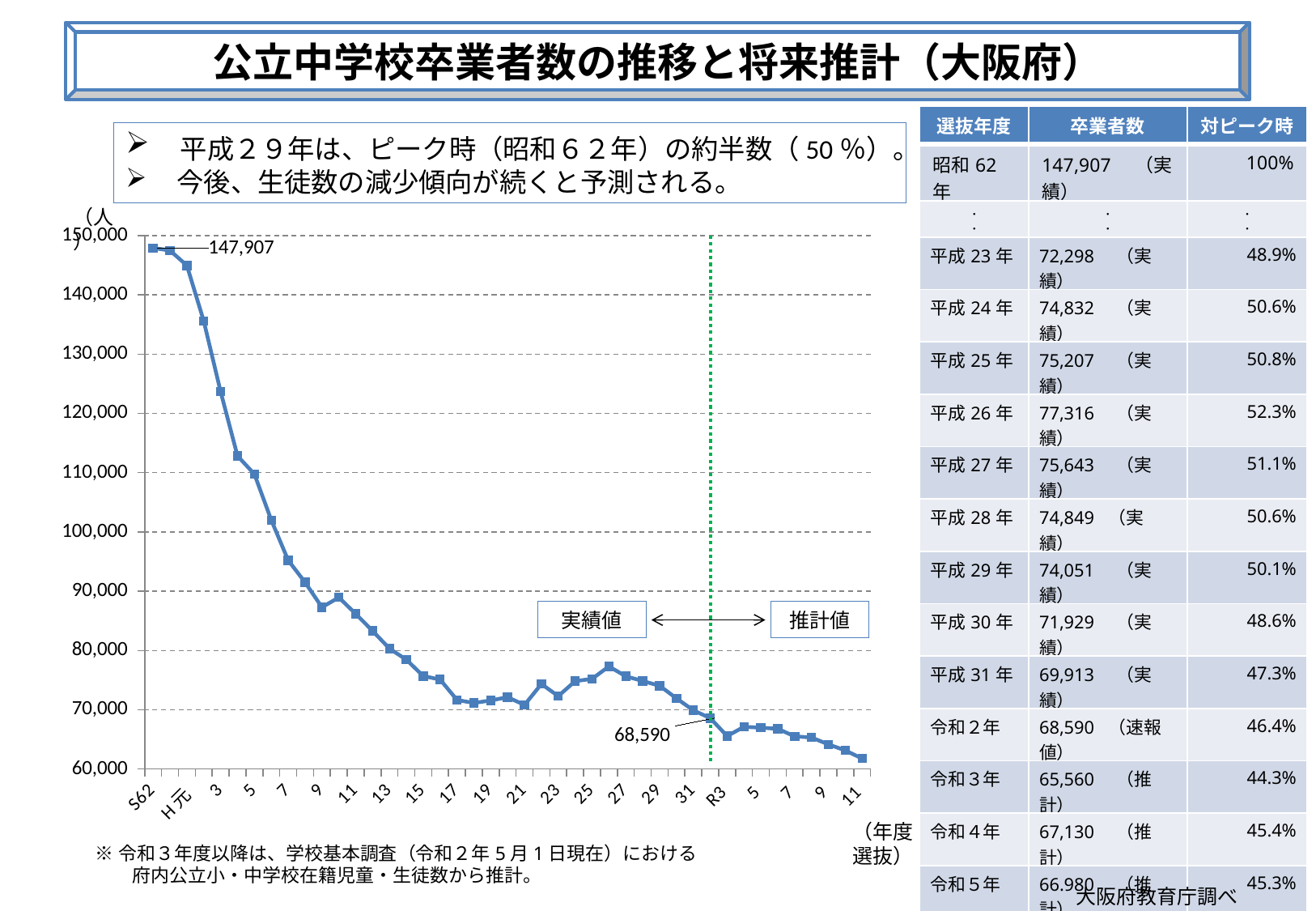
What value is labelled on the chart just before the green dotted line (the last actual value)? 68,590 Is the value for H1 (H元) greater or less than 140,000? greater Is the value for H7 greater or less than 100,000? less Which year has the lowest number of graduates on the chart? R11 Which is larger, the value for H27 or the value for H17? H27 What kind of chart is shown on the slide? line chart Which year has the highest number of graduates on the chart? S62 What two labels does the green dotted line separate on the chart? 実績値 and 推計値 Is the value for R11 greater or less than 70,000? less Overall, do the values rise or fall from S62 to R11 along the x axis? fall What is the number of graduates labelled for S62 (昭和62年) on the chart? 147,907 What is the difference between the labelled peak value 147,907 and the labelled value 68,590? 79,317